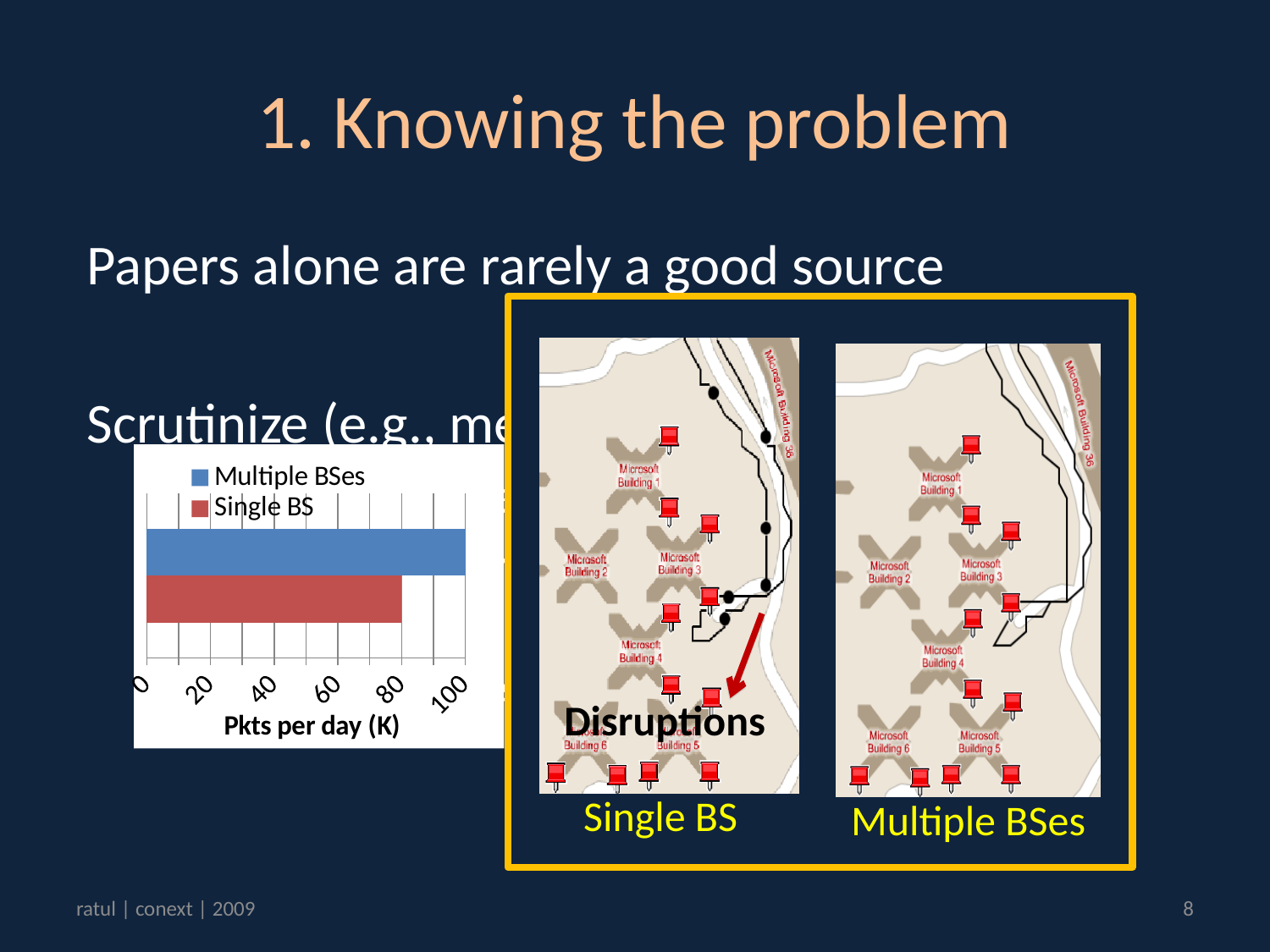
What is the x-axis title of the bar chart? Pkts per day (K) How many series does the legend of the bar chart list? 2 Which series has the highest value in the bar chart? Multiple BSes Is the value for Single BS greater or less than 60? greater Is the value for Multiple BSes greater or less than 80? greater What colour is the Single BS bar in the bar chart? red Which series has the larger value in the bar chart, Multiple BSes or Single BS? Multiple BSes Is the value for Multiple BSes greater or less than 40? greater Which series has the lowest value in the bar chart? Single BS What kind of chart is shown on the left of the slide? bar chart How many bars are plotted in the bar chart? 2